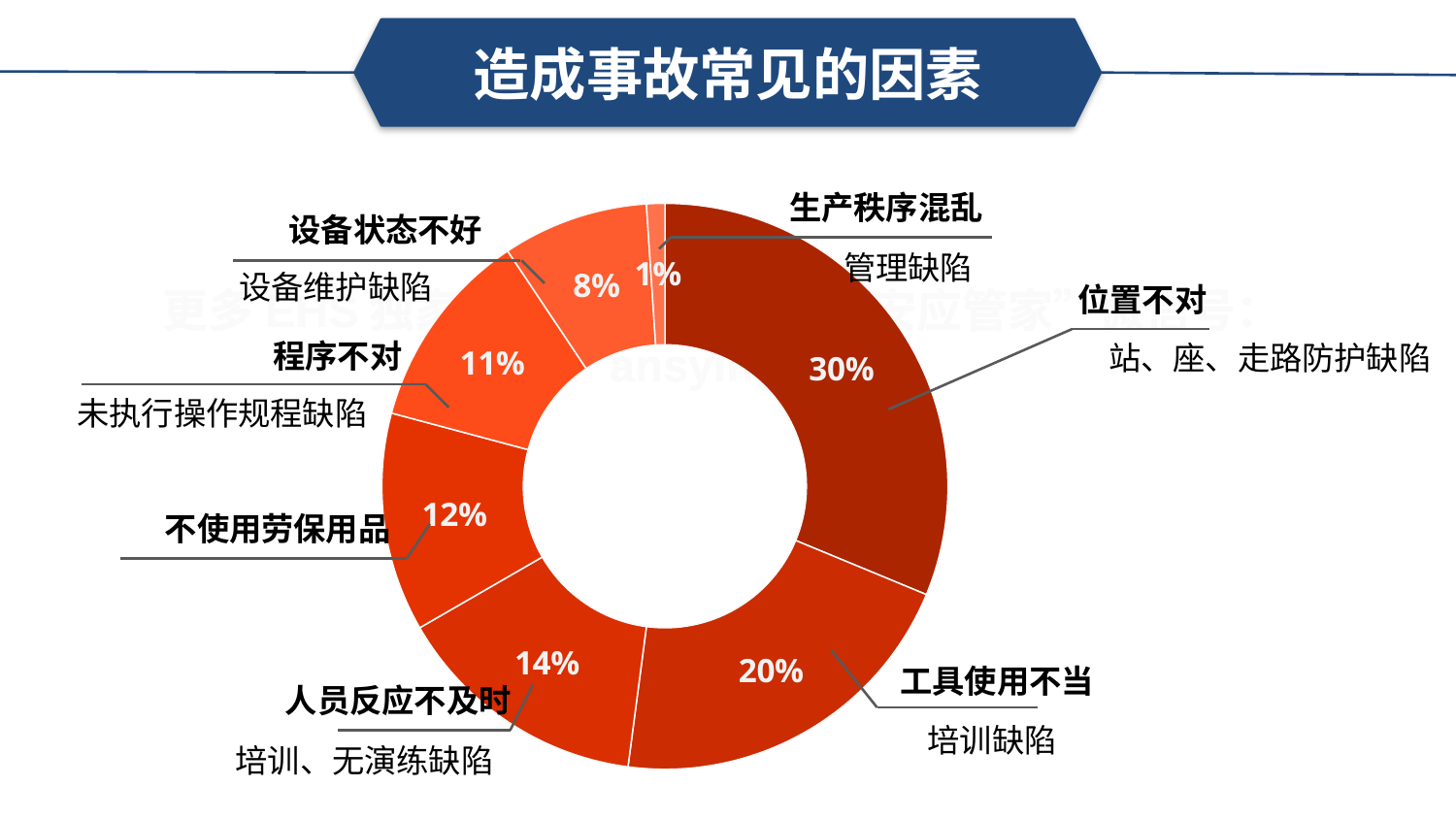
Which has a larger share, 人员反应不及时 or 程序不对? 人员反应不及时 What is the title of the slide containing the chart? 造成事故常见的因素 What percentage is shown for 不使用劳保用品? 12% What share of the chart does 设备状态不好 account for? 8% What percentage is shown for 程序不对? 11% What is the difference between the shares of 位置不对 and 工具使用不当? 10% Which factor has the largest share in the chart? 位置不对 What type of chart is shown on the slide? Donut (pie) chart What percentage is shown for 工具使用不当? 20% What percentage is shown for 位置不对? 30% Which factor has the smallest share in the chart? 生产秩序混乱 What percentage is shown for 人员反应不及时? 14%